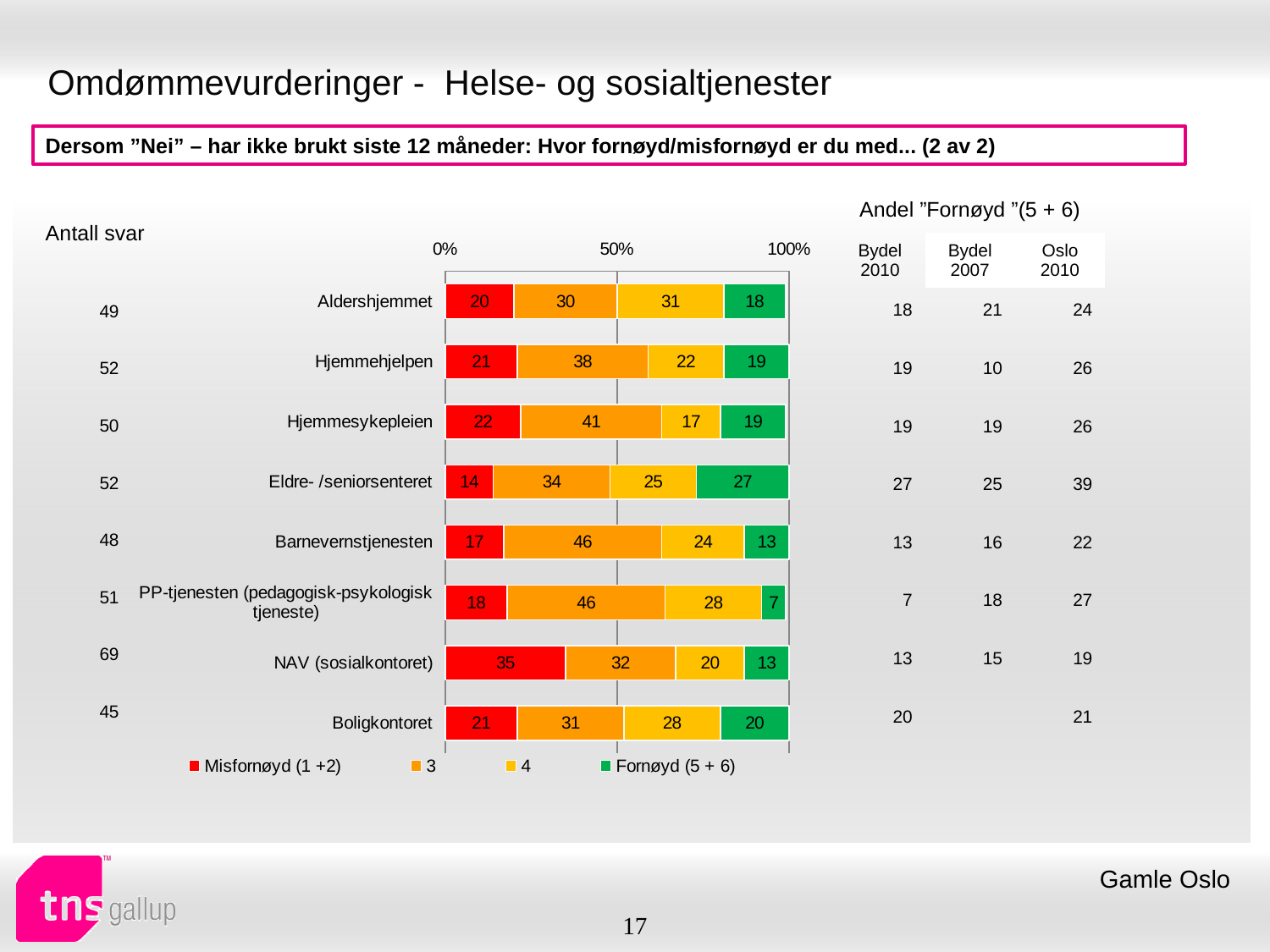
How many series does the chart legend list? 4 How many service categories are plotted in the chart? 8 Which category has the highest Misfornøyd (1 +2) value? NAV (sosialkontoret) What is the difference between the Fornøyd (5 + 6) values for Eldre- /seniorsenteret and Barnevernstjenesten? 14 What kind of chart is shown on the slide? Stacked bar chart Which has the larger value for series 3: Hjemmesykepleien or Aldershjemmet? Hjemmesykepleien What is the total of the four segments in the Aldershjemmet bar? 99 What is the value of series 4 for PP-tjenesten (pedagogisk-psykologisk tjeneste)? 28 Which category has the lowest Fornøyd (5 + 6) value? PP-tjenesten (pedagogisk-psykologisk tjeneste) What is the Fornøyd (5 + 6) value for Eldre- /seniorsenteret? 27 What is the Misfornøyd (1 +2) value for NAV (sosialkontoret)? 35 What is the first entry in the chart legend? Misfornøyd (1 +2)